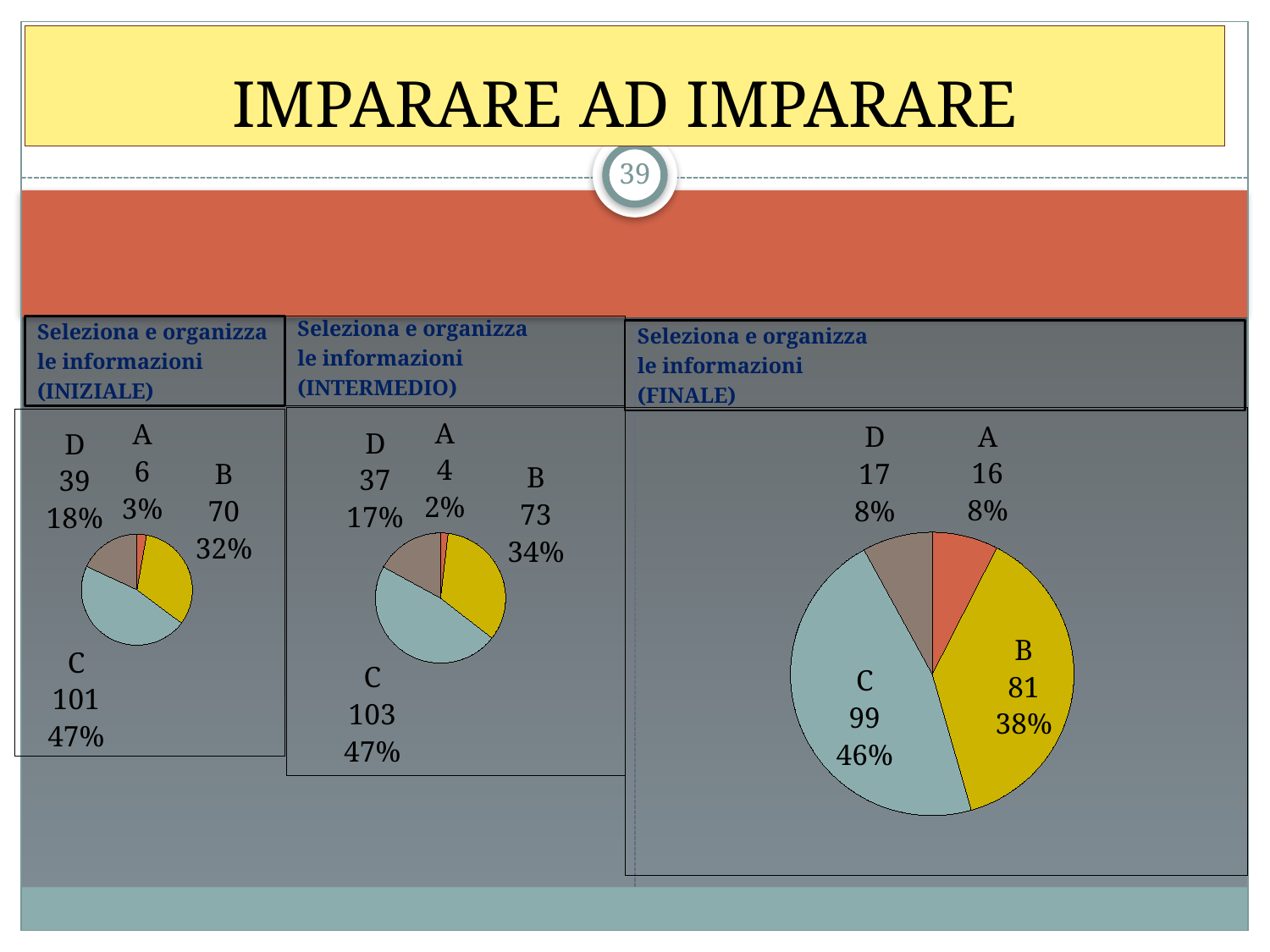
In the INIZIALE pie chart, what is the value for category C? 101 In the INIZIALE pie chart, which category has the smallest value? A In the FINALE pie chart, what is the value for category B? 81 In the INTERMEDIO pie chart, what share of the pie does category C represent? 47% In the INIZIALE pie chart, what share of the pie does category B represent? 32% How many categories does the FINALE pie chart show? 4 In the INTERMEDIO pie chart, which category has the largest value? C In the INTERMEDIO pie chart, what is the value for category D? 37 In the INTERMEDIO pie chart, what is the difference between the values for B and D? 36 In the FINALE pie chart, which is larger, the value for C or the value for B? C What kind of chart is used in the INIZIALE panel? Pie chart In the FINALE pie chart, what share of the pie does category A represent? 8%